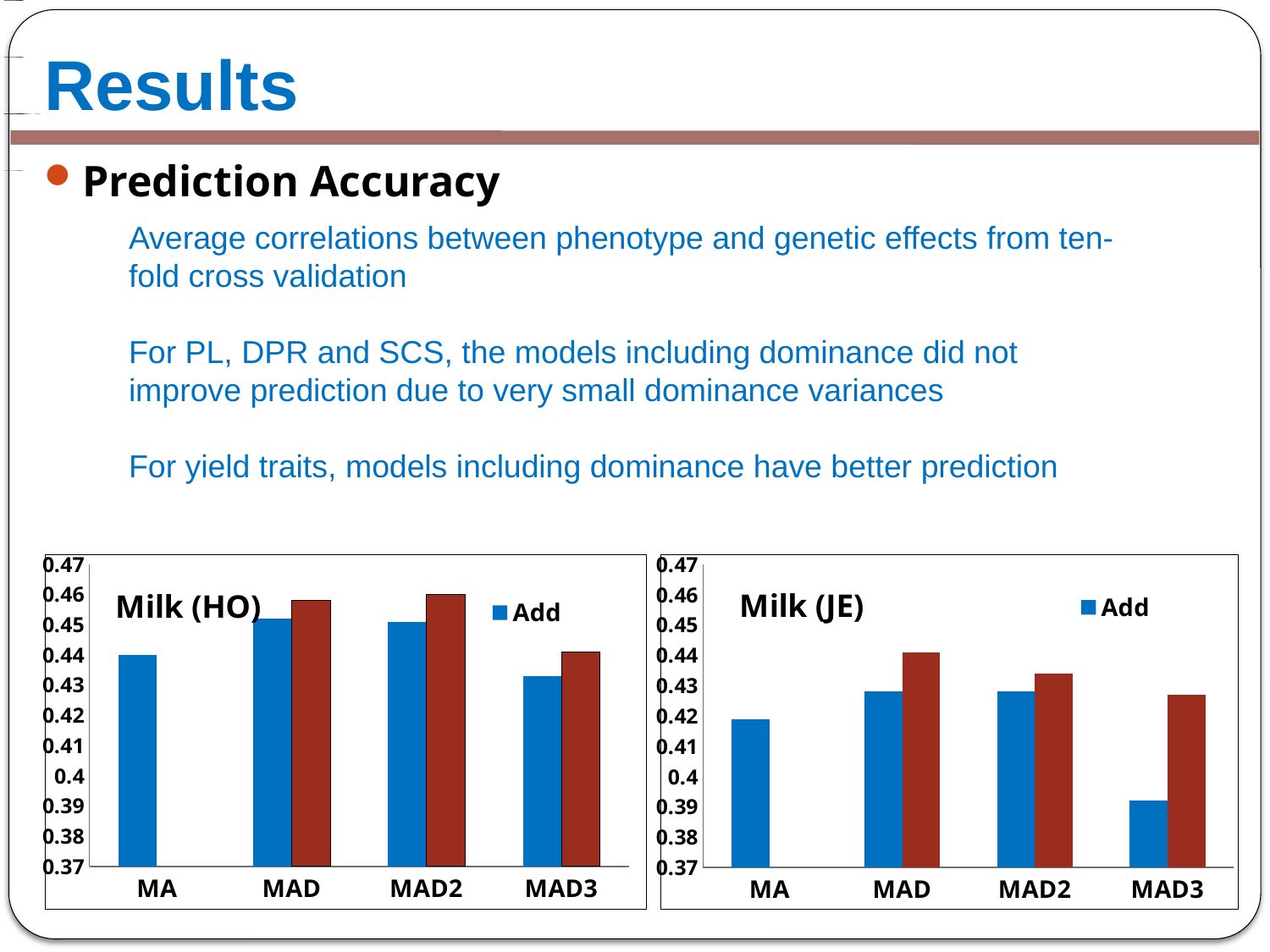
In the Milk (HO) chart, which has the larger Add value, MAD or MAD3? MAD In the Milk (HO) chart, is the Add value for MAD3 greater or less than 0.44? less In the Milk (JE) chart, which category has the lowest Add value? MAD3 In the Milk (HO) chart, which category has the lowest Add value? MAD3 What is the series name shown in the legend of the Milk (HO) chart? Add In the Milk (HO) chart, is the Add value for MA greater or less than 0.43? greater In the Milk (JE) chart, is the Add value for MA greater or less than 0.41? greater In the Milk (JE) chart, which has the larger Add value, MA or MAD? MAD How many series does the legend of the Milk (JE) chart list? 1 How many categories are shown on the x axis of the Milk (HO) chart? 4 What kind of chart is the Milk (HO) chart? bar chart